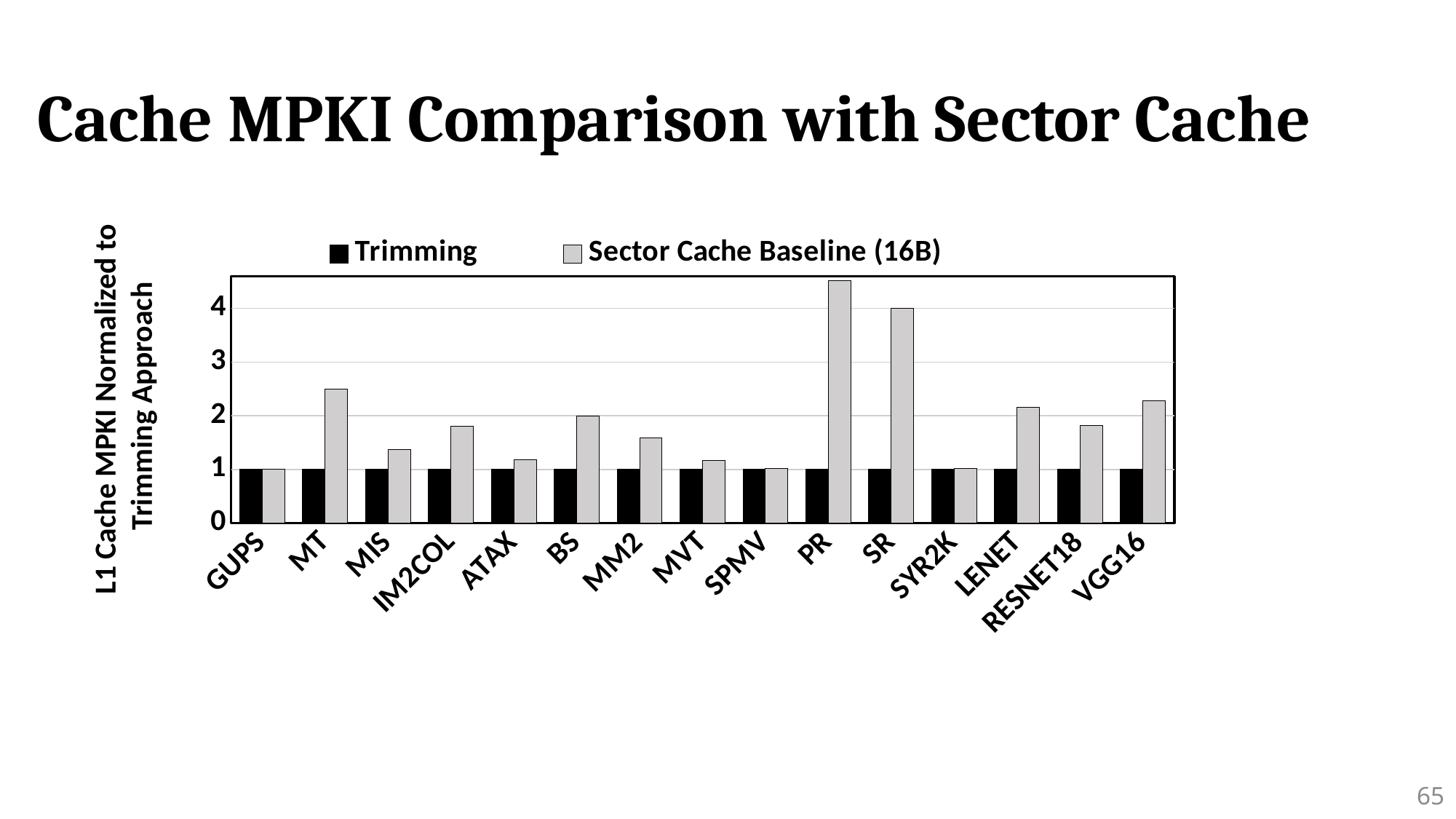
What is the y-axis label of the chart? L1 Cache MPKI Normalized to Trimming Approach What kind of chart is shown on the slide? bar chart How many series does the legend list? 2 Which has the larger Sector Cache Baseline (16B) value, MT or MIS? MT Which has the larger Sector Cache Baseline (16B) value, PR or SR? PR Is the Sector Cache Baseline (16B) value for ATAX greater or less than 2? less Is the Sector Cache Baseline (16B) value for PR greater or less than 4? greater What is the Trimming value for GUPS? 1 How many benchmark categories are shown on the x axis? 15 Is the Sector Cache Baseline (16B) value for SR greater or less than 3? greater Which category has the highest Sector Cache Baseline (16B) value? PR